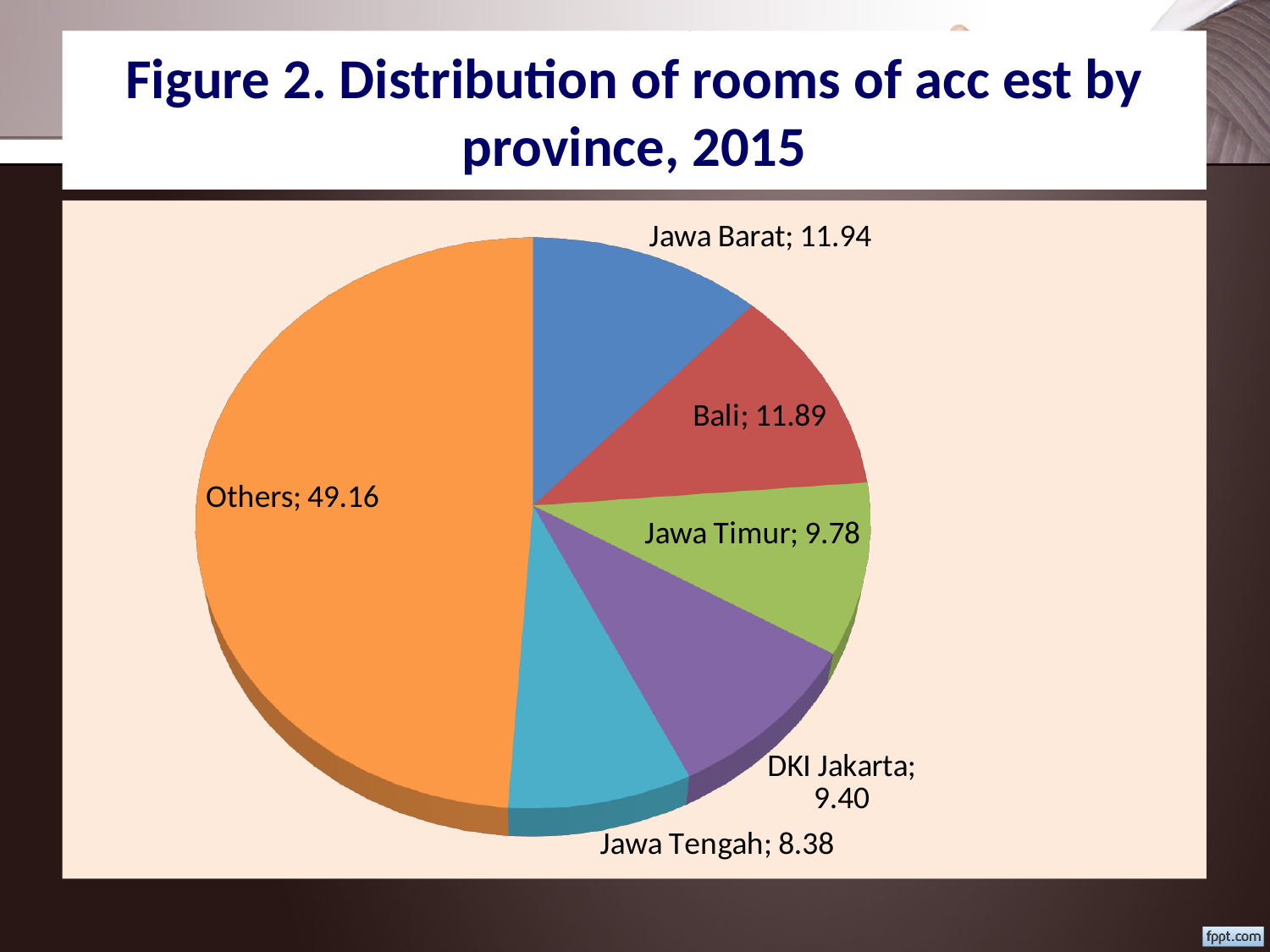
What is the difference between the values for Others and Jawa Barat? 37.22 How many slices does the pie chart have? 6 What is the title of the chart on the slide? Figure 2. Distribution of rooms of acc est by province, 2015 Which slice of the pie chart is the largest? Others Which is larger, the value for Jawa Timur or the value for Jawa Tengah? Jawa Timur What value is shown for Jawa Tengah in the pie chart? 8.38 What value is shown for Bali in the pie chart? 11.89 Which named province has the smallest slice in the pie chart? Jawa Tengah What type of chart is shown on the slide? Pie chart What is the difference between the values for Jawa Timur and DKI Jakarta? 0.38 What value is shown for DKI Jakarta in the pie chart? 9.40 What value is shown for Jawa Barat in the pie chart? 11.94